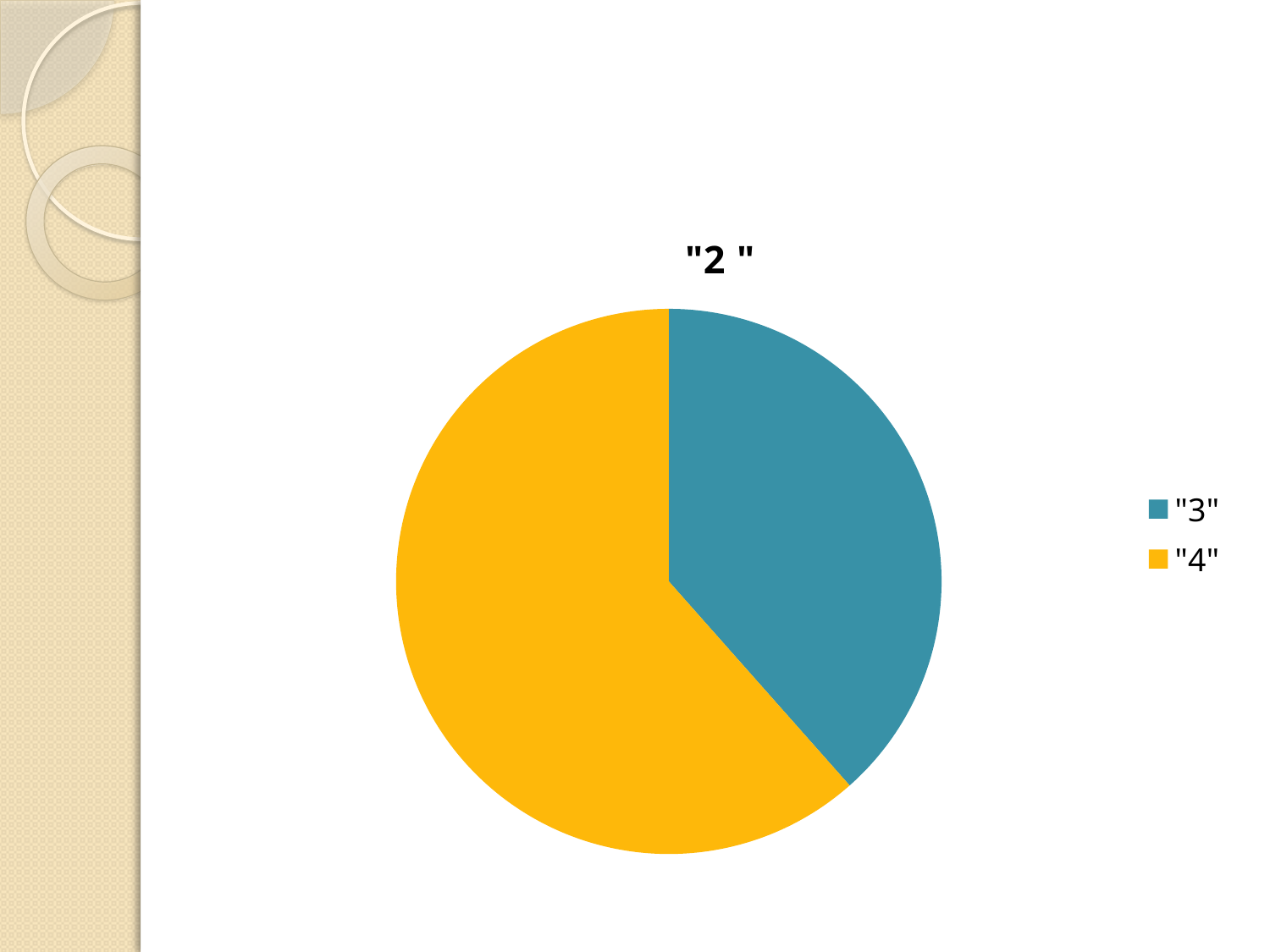
What is the title of the pie chart? "2 " How many slices does the pie chart have? 2 Which category has the largest slice in the pie chart? "4" How many entries does the legend of the pie chart list? 2 Which slice is larger in the pie chart, "3" or "4"? "4" What kind of chart is shown on the slide? pie chart What colour is the slice for "4" in the pie chart? yellow Which category has the smallest slice in the pie chart? "3"